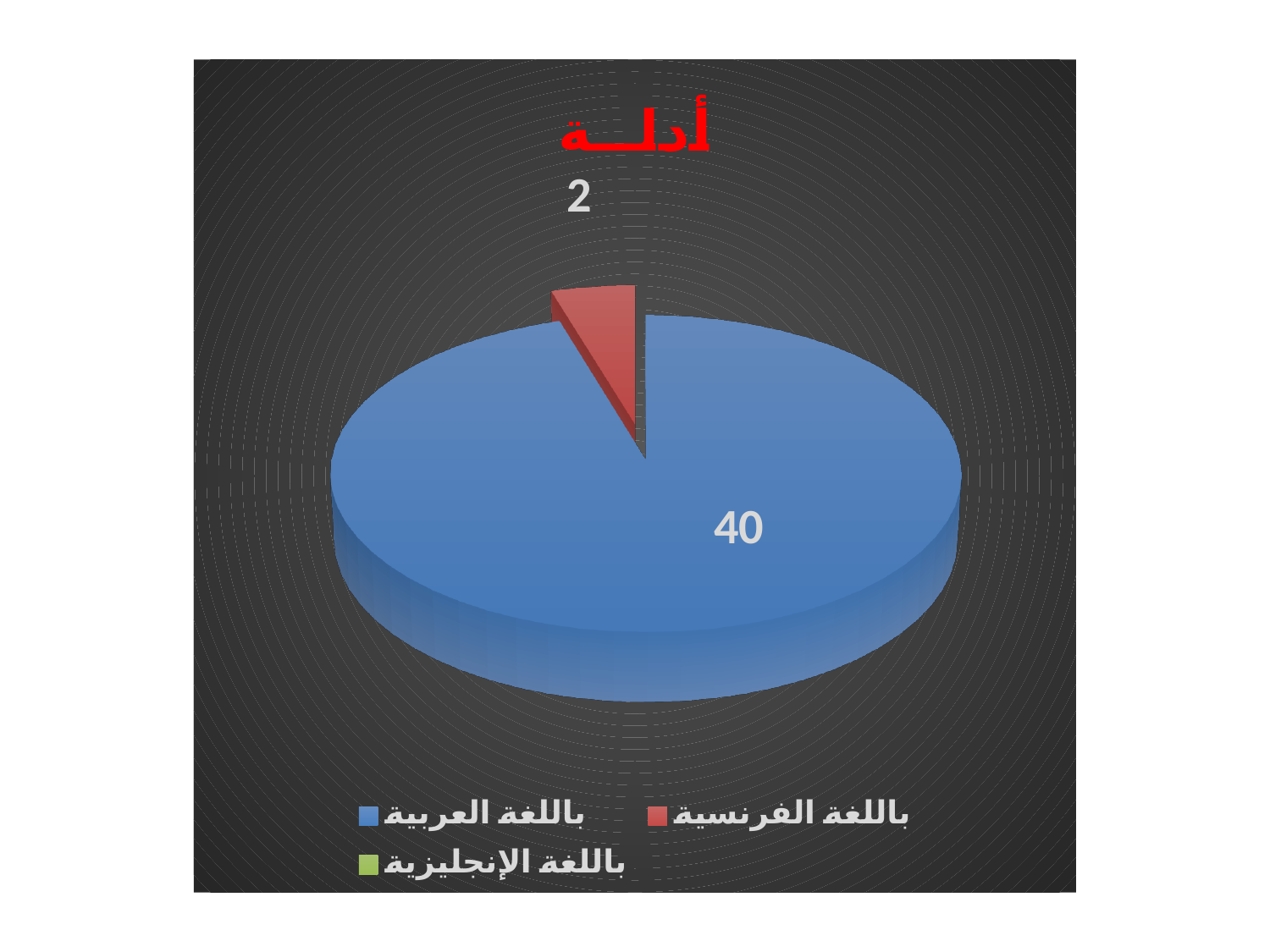
Which category has the largest slice in the pie chart? باللغة العربية Which is larger, the value for باللغة العربية or the value for باللغة الفرنسية? باللغة العربية What kind of chart is shown on the slide? Pie chart How many entries does the legend list? 3 What colour is the slice for باللغة العربية? Blue What value is shown for باللغة الفرنسية in the pie chart? 2 What is the title of the chart? أدلـــة How many data labels are printed on the pie chart? 2 What is the difference between the values for باللغة العربية and باللغة الفرنسية? 38 What value is shown for باللغة العربية in the pie chart? 40